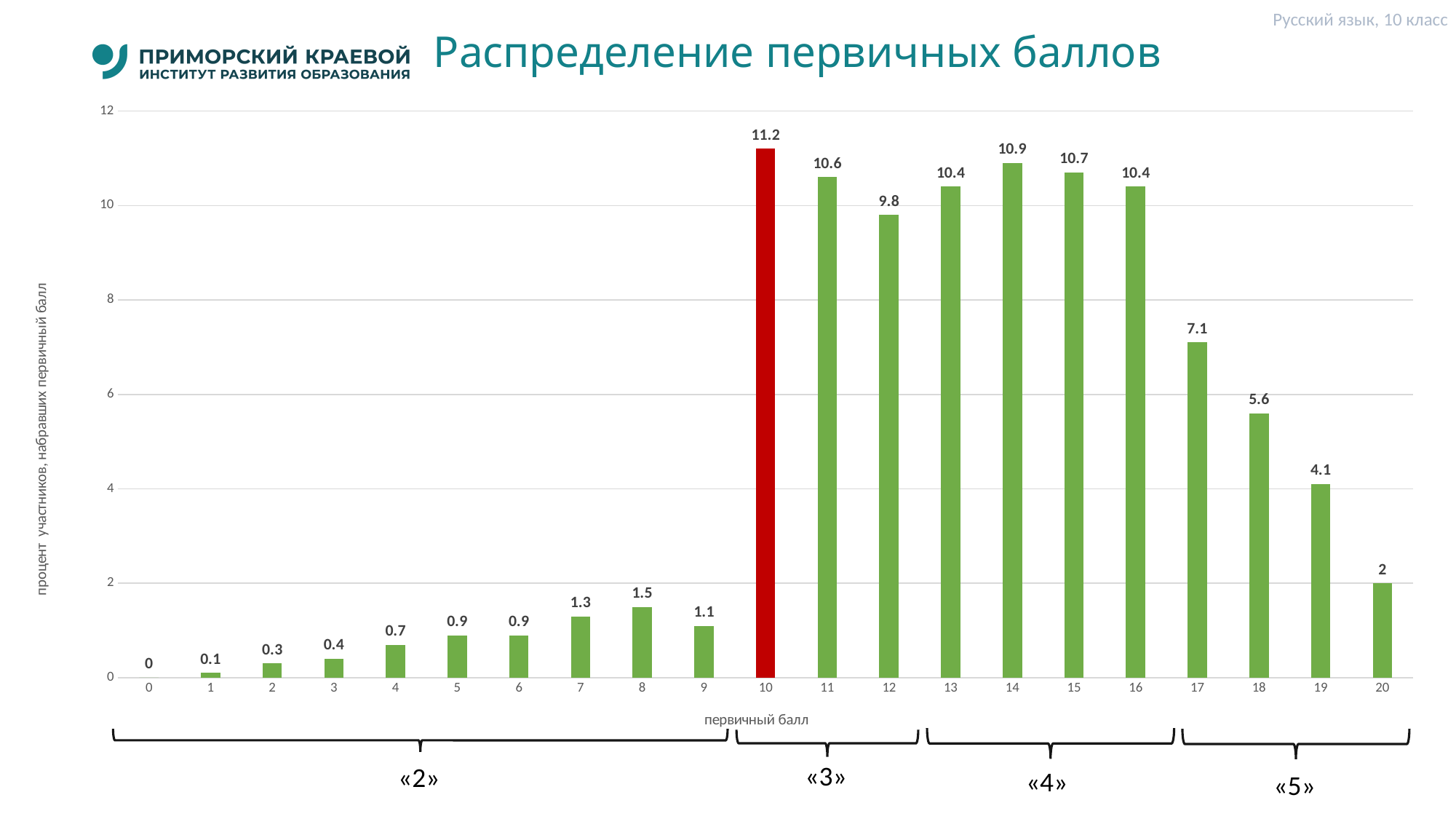
Which primary score has the lowest percentage of participants? 0 Which has a larger value: primary score 8 or primary score 9? 8 What percentage of participants scored 10 primary points? 11.2 What is the value shown for a primary score of 17? 7.1 How many primary score categories are shown on the x axis? 21 What kind of chart is shown on the slide? bar chart Do the values rise or fall from primary score 17 to primary score 20? fall Which bar is coloured red instead of green? 10 What is the value shown for a primary score of 20? 2 Is the value for primary score 18 greater or less than 6? less What is the difference between the values for primary scores 14 and 12? 1.1 Which primary score has the highest percentage of participants? 10